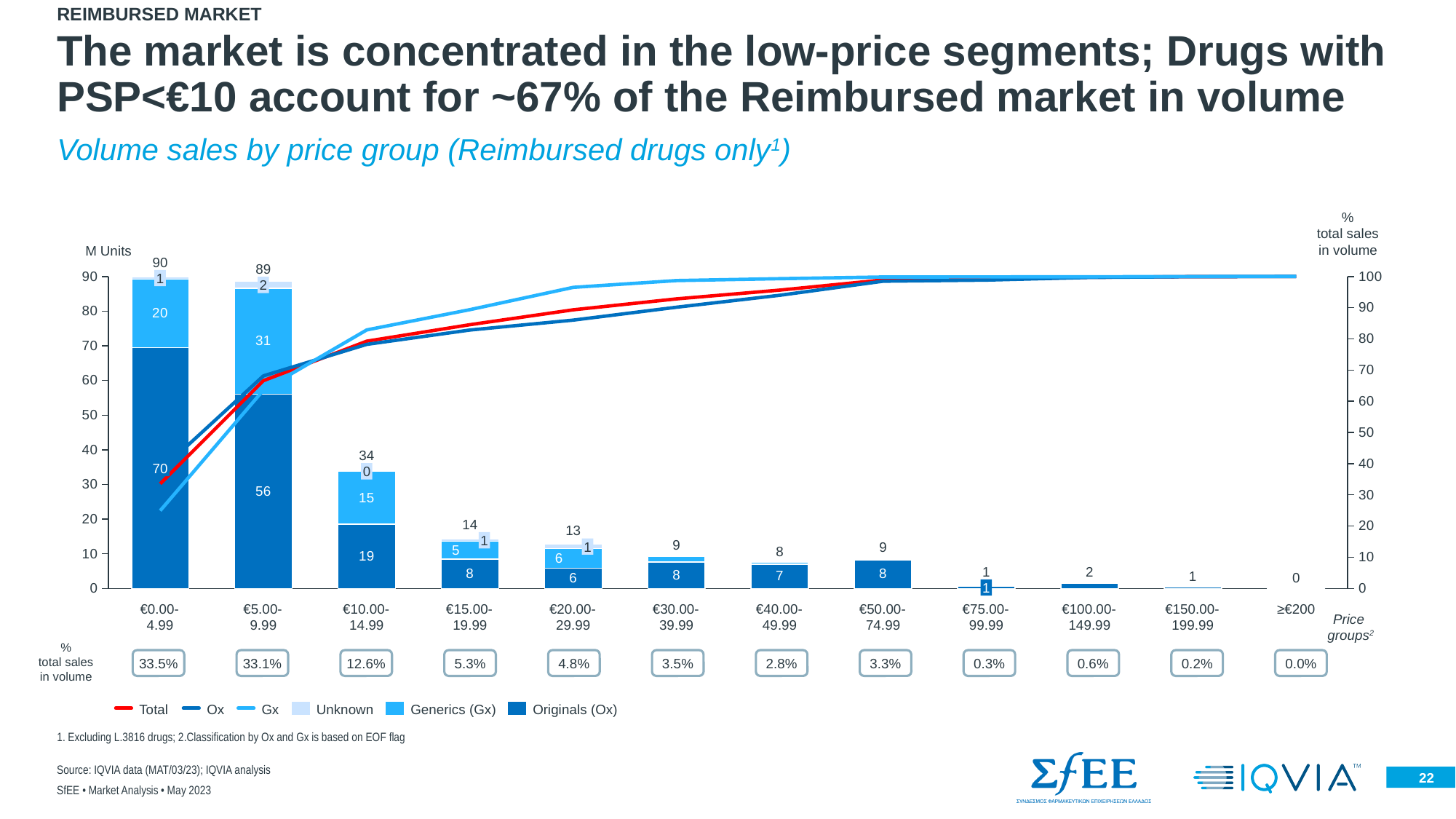
Which price group has the highest total volume? €0.00-4.99 What is the total volume (M Units) for the €10.00-14.99 price group? 34 What is the difference in total volume between the €0.00-4.99 and €10.00-14.99 price groups? 56 What percentage of total sales in volume does the €10.00-14.99 price group account for? 12.6% How many price groups are shown on the x axis? 12 What kind of chart is used for the volume by price group? Stacked bar chart with line series Do the total bar volumes rise or fall as the price groups increase along the x axis? Fall What is the Originals (Ox) volume for the €5.00-9.99 price group? 56 What is the Generics (Gx) volume for the €0.00-4.99 price group? 20 Which has a larger Originals (Ox) volume: €0.00-4.99 or €5.00-9.99? €0.00-4.99 Which price group has the lowest total volume? ≥€200 How many entries does the legend list? 6